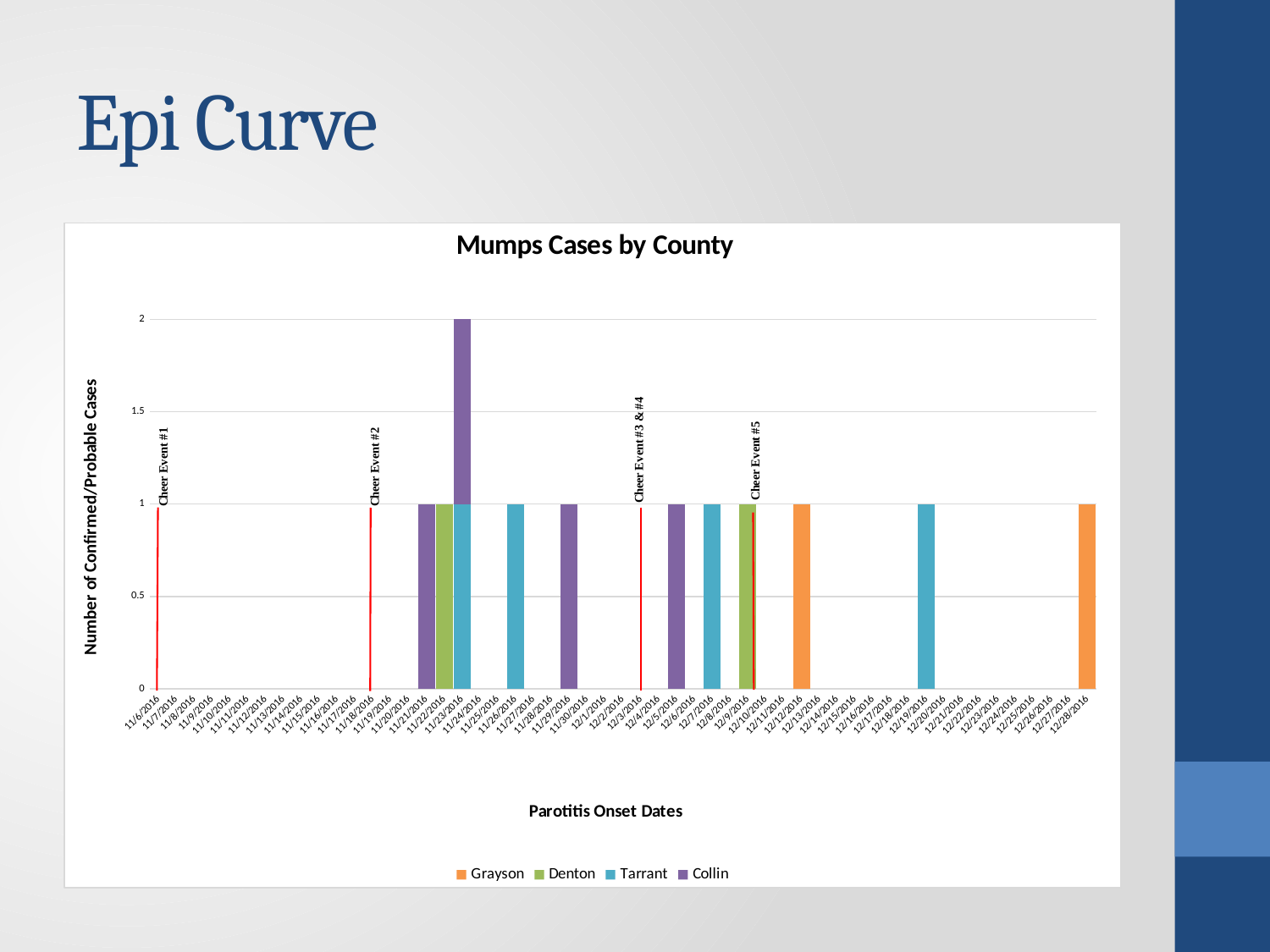
What is the title of the chart? Mumps Cases by County How many series does the legend list? 4 How many bars are plotted for Denton? 2 How many bars are plotted for Grayson? 2 Which county has the tallest bar in the chart? Collin What is the value of the tallest bar in the chart? 2 What is the label of the y axis? Number of Confirmed/Probable Cases Is the tallest bar in the chart greater or less than 1.5? greater Which is larger, the tallest Collin bar or the tallest Tarrant bar? Collin How many red vertical cheer event lines are drawn on the chart? 4 What type of chart is shown on the slide? bar chart What is the difference between the tallest Collin bar and the tallest Grayson bar? 1